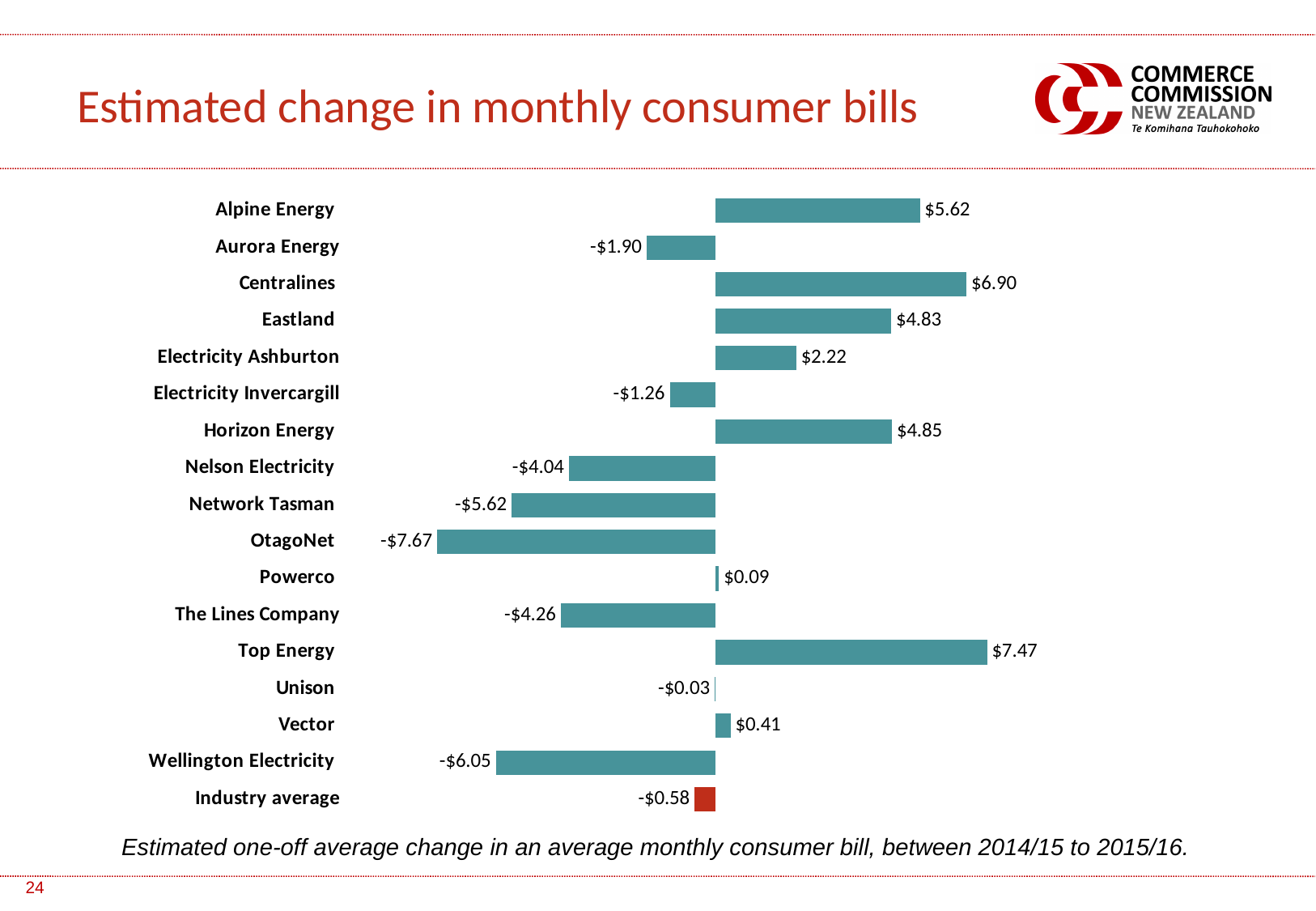
What is the industry average change in monthly consumer bills? -$0.58 Which bar is shown in a different colour (red) from the others? Industry average What is the value shown for Wellington Electricity? -$6.05 How many categories (bars) are shown in the chart, including the industry average? 17 What type of chart is shown on the slide? Bar chart Which company has the lowest (most negative) estimated change in monthly consumer bills? OtagoNet Which has a larger estimated change, Alpine Energy or Centralines? Centralines Which company has the largest estimated increase in monthly consumer bills? Top Energy What is the difference between the values for Centralines and Alpine Energy? $1.28 What is the value shown for OtagoNet? -$7.67 Which has a larger estimated change, Electricity Ashburton or Eastland? Eastland What is the estimated change in monthly consumer bills for Top Energy? $7.47